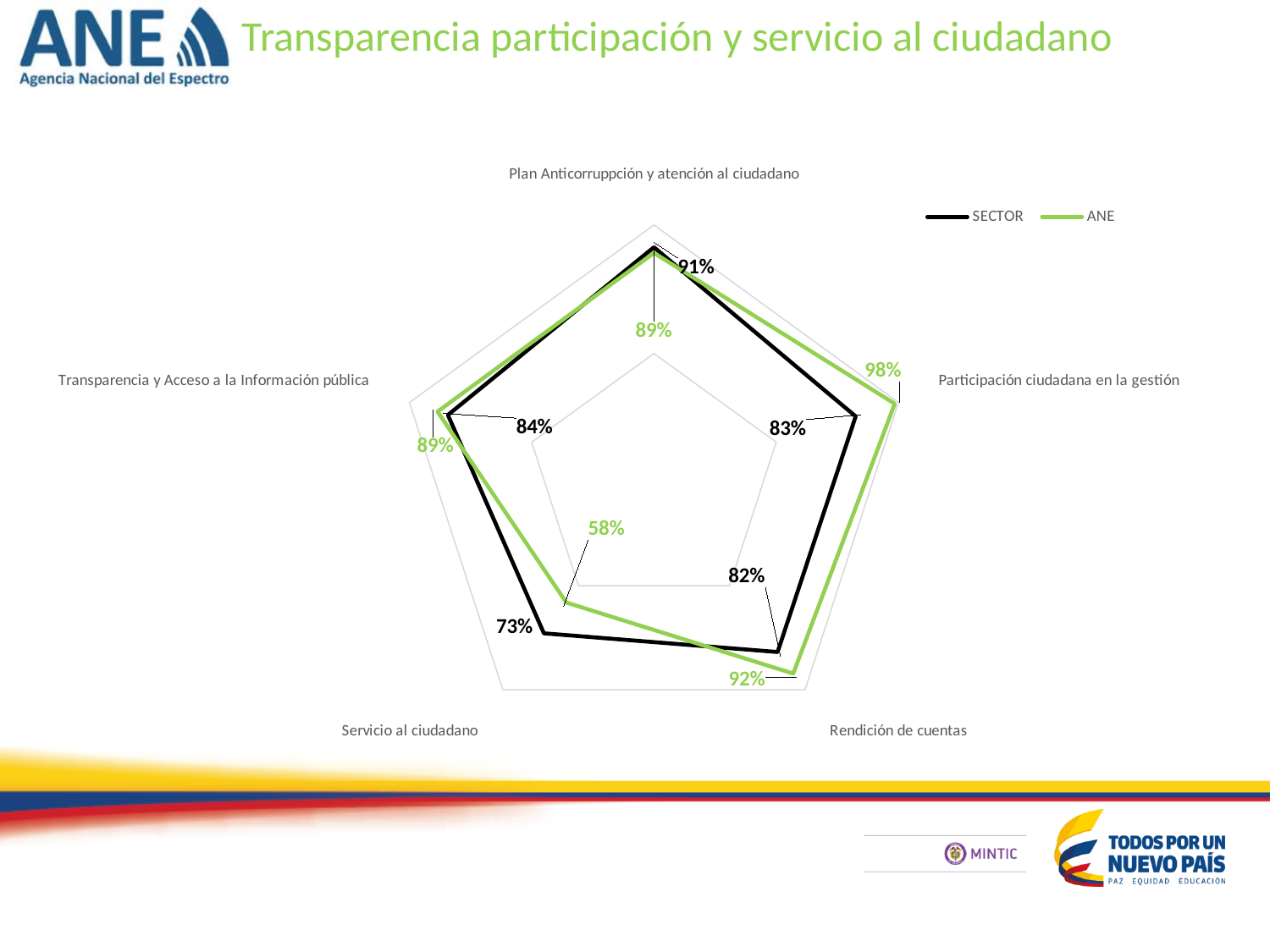
Which category has the lowest ANE value? Servicio al ciudadano What is the SECTOR value for Transparencia y Acceso a la Información pública? 84% For Servicio al ciudadano, which series has the larger value, SECTOR or ANE? SECTOR Which category has the highest ANE value? Participación ciudadana en la gestión How many categories (axes) does the radar chart have? 5 Which colour represents the ANE series in the chart? green What is the SECTOR value for Servicio al ciudadano? 73% What is the ANE value for Rendición de cuentas? 92% How many series does the legend list? 2 What is the ANE value for Participación ciudadana en la gestión? 98% What is the difference between the ANE and SECTOR values for Participación ciudadana en la gestión? 15% What type of chart is shown on the slide? radar chart